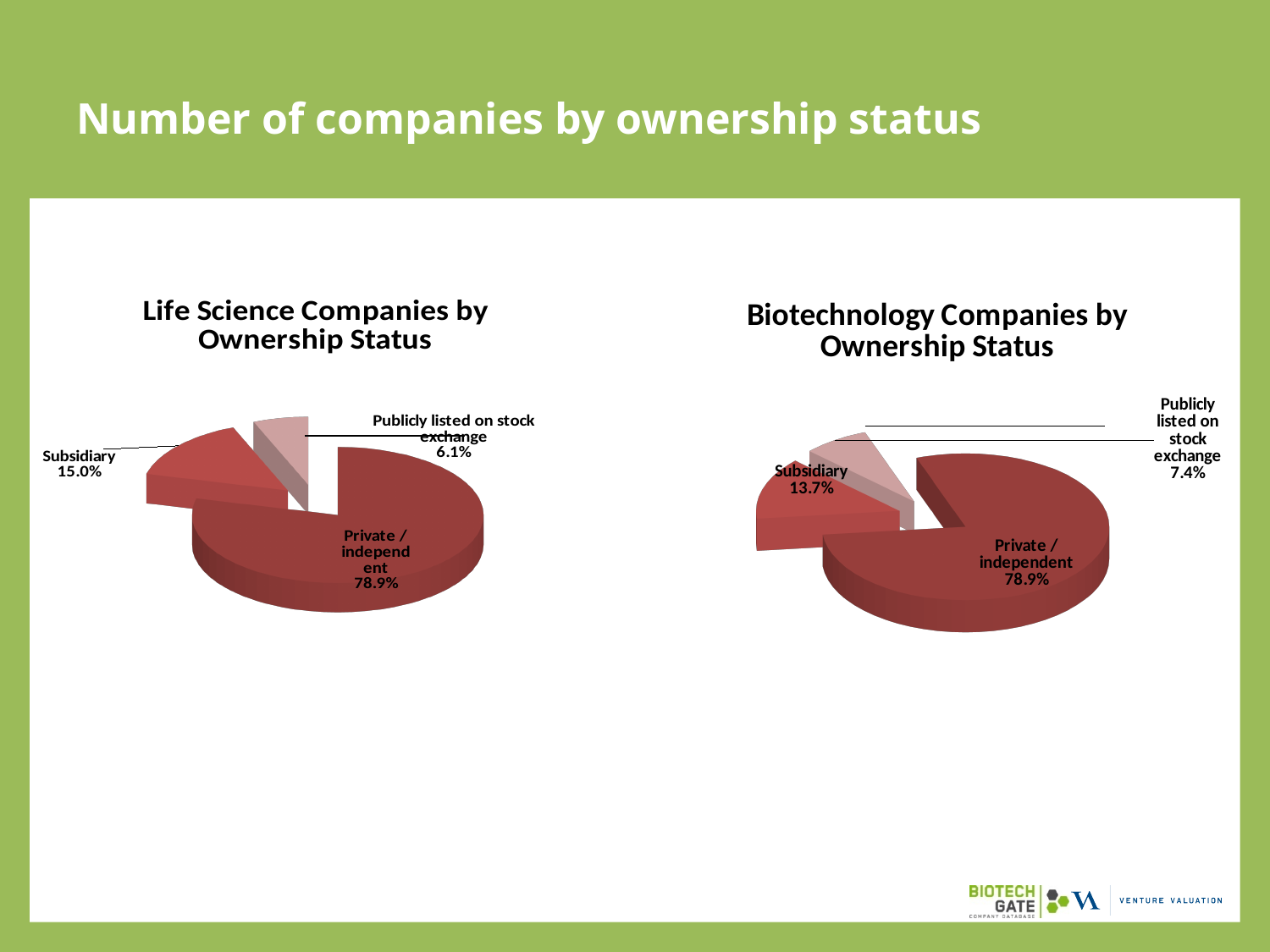
How many slices does the 'Biotechnology Companies by Ownership Status' chart have? 3 In the 'Life Science Companies by Ownership Status' chart, what share is Publicly listed on stock exchange? 6.1% In the 'Life Science Companies by Ownership Status' chart, which category has the smallest share? Publicly listed on stock exchange In the 'Biotechnology Companies by Ownership Status' chart, which is larger: Subsidiary or Publicly listed on stock exchange? Subsidiary In the 'Life Science Companies by Ownership Status' chart, what share is Subsidiary? 15.0% In the 'Biotechnology Companies by Ownership Status' chart, what share is Subsidiary? 13.7% In the 'Biotechnology Companies by Ownership Status' chart, which category has the largest share? Private / independent What is the title of the chart on the right side of the slide? Biotechnology Companies by Ownership Status What type of chart is the 'Life Science Companies by Ownership Status' chart? Pie chart In the 'Life Science Companies by Ownership Status' chart, what share is Private / independent? 78.9% In the 'Life Science Companies by Ownership Status' chart, what is the difference between the Subsidiary share and the Publicly listed on stock exchange share? 8.9% In the 'Biotechnology Companies by Ownership Status' chart, what share is Publicly listed on stock exchange? 7.4%